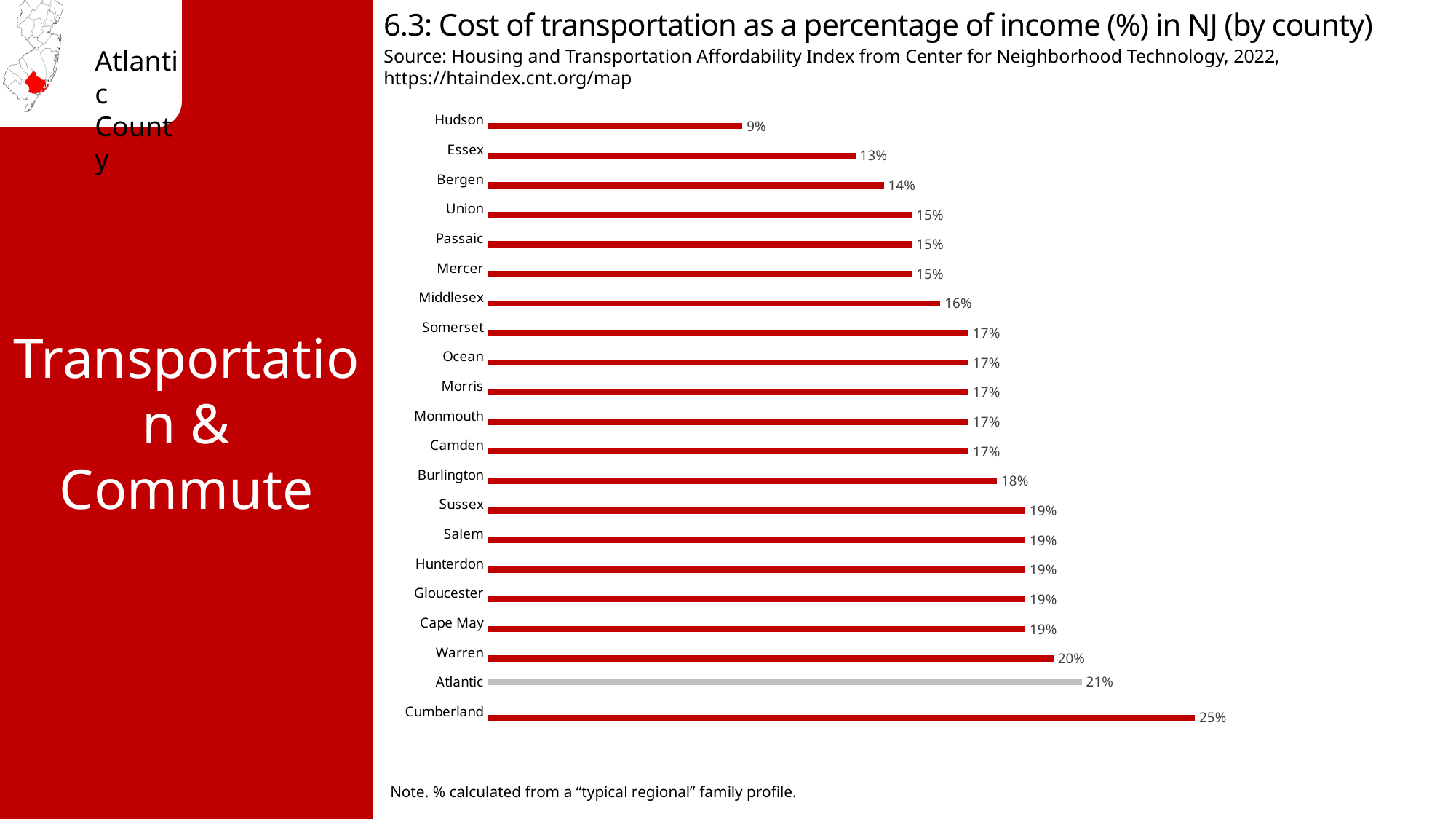
Which county's bar is coloured grey instead of red? Atlantic Which county has the lowest cost of transportation as a percentage of income? Hudson How many counties are shown in the chart? 21 Which county has the highest cost of transportation as a percentage of income? Cumberland What kind of chart is shown on the slide? Bar chart What is the value shown for Hudson? 9% What is the difference between the values for Cumberland and Atlantic? 4% Which is larger, the value for Warren or the value for Burlington? Warren What is the value shown for Bergen? 14% What is the cost of transportation as a percentage of income for Atlantic County? 21% What is the difference between the values for Essex and Hudson? 4% What is the value shown for Middlesex? 16%